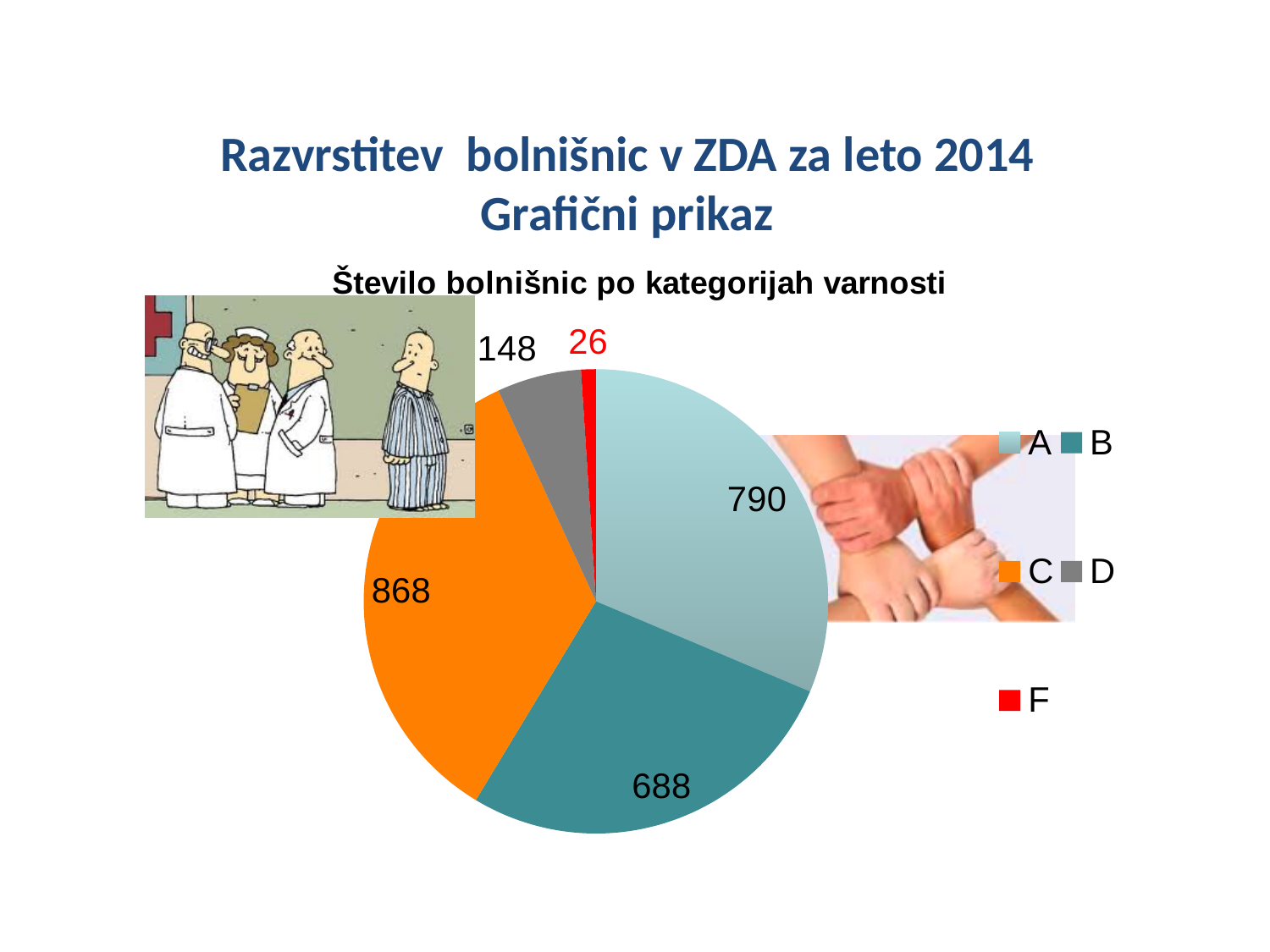
What kind of chart is shown on the slide? Pie chart What is the total of all the values in the pie chart? 2520 What is the value for category C? 868 Which is larger, the value for A or the value for B? A Which category has the highest value? C What is the difference between the values for C and A? 78 Which category has the lowest value? F How many categories does the pie chart show? 5 What is the title of the chart? Število bolnišnic po kategorijah varnosti What is the value for category F? 26 What is the value for category D? 148 What is the value for category A? 790